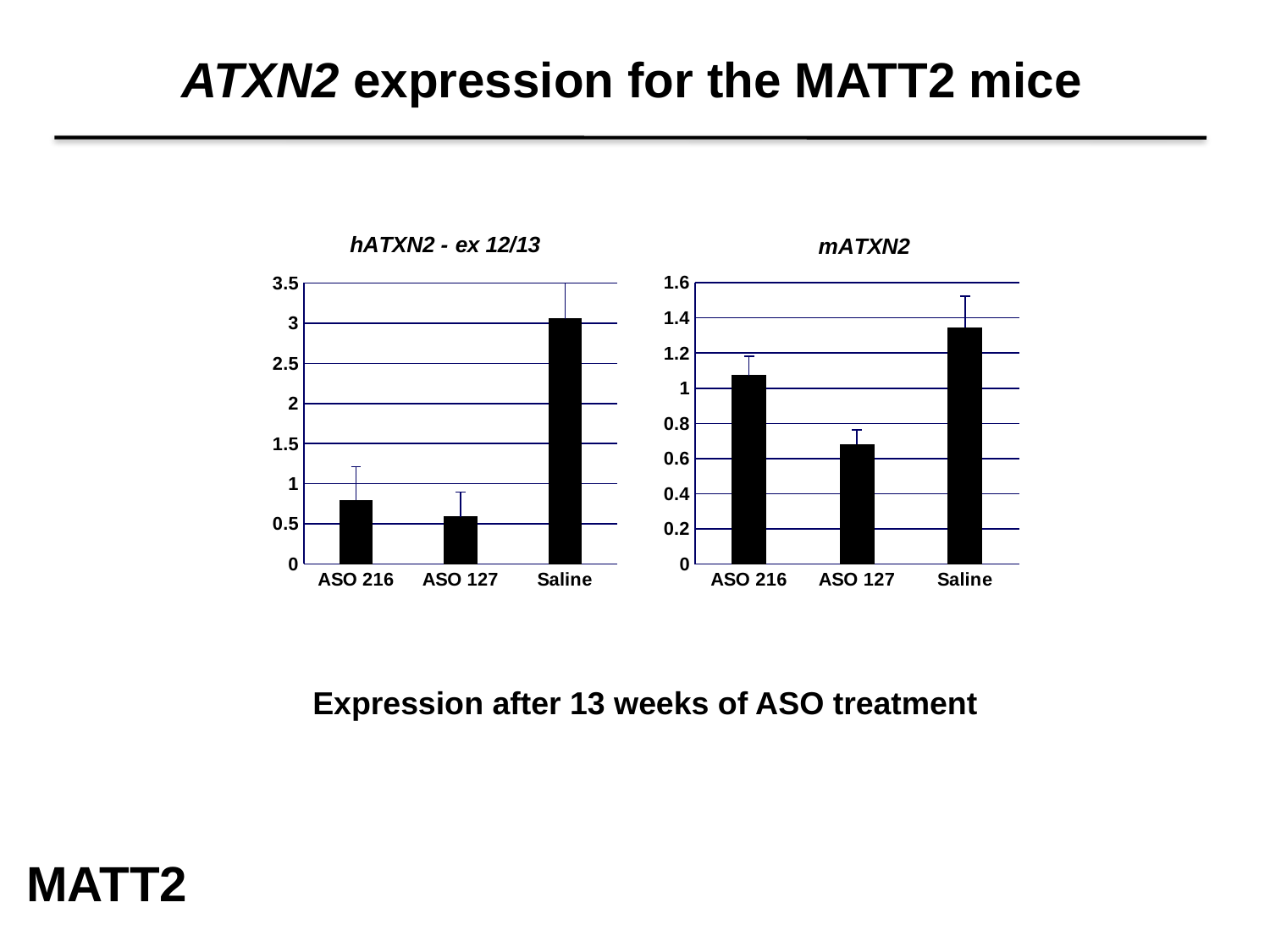
In the mATXN2 chart, is the value for ASO 127 greater or less than 0.8? less In the hATXN2 - ex 12/13 chart, what kind of chart is shown? bar chart In the mATXN2 chart, which is larger, the value for ASO 216 or the value for ASO 127? ASO 216 In the hATXN2 - ex 12/13 chart, which category has the highest value? Saline What is the title of the chart on the right of the slide? mATXN2 In the hATXN2 - ex 12/13 chart, how many categories are plotted? 3 In the hATXN2 - ex 12/13 chart, is the value for ASO 216 greater or less than 1? less In the mATXN2 chart, which category has the highest value? Saline In the mATXN2 chart, is the value for ASO 216 greater or less than 1? greater In the mATXN2 chart, which category has the lowest value? ASO 127 In the hATXN2 - ex 12/13 chart, which category has the lowest value? ASO 127